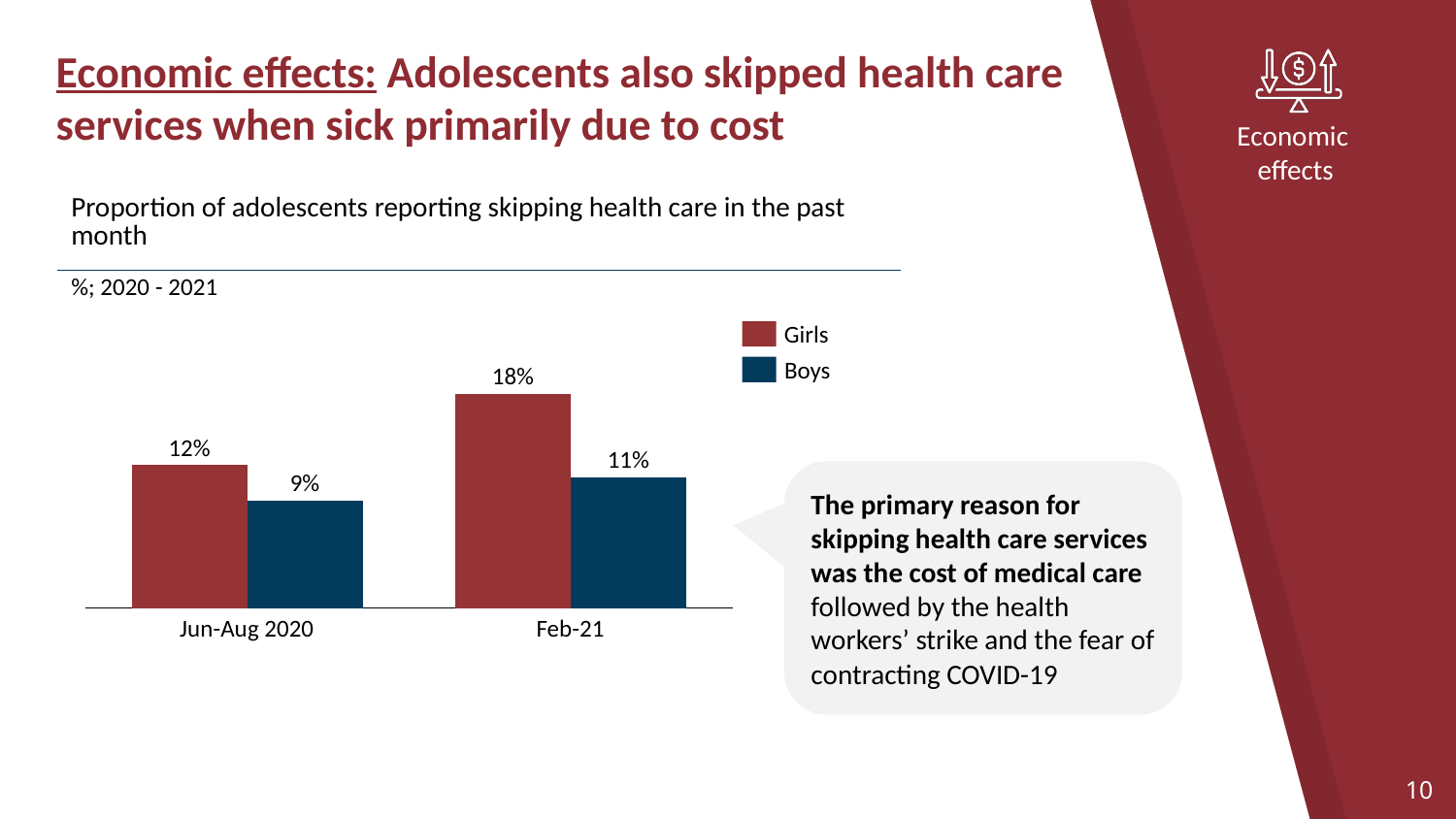
Which is larger: the value for boys in Feb-21 or the value for girls in Jun-Aug 2020? Girls in Jun-Aug 2020 Which group and period has the lowest proportion of adolescents skipping health care? Boys, Jun-Aug 2020 What percentage of girls reported skipping health care in Jun-Aug 2020? 12% Do the values for both girls and boys rise or fall from Jun-Aug 2020 to Feb-21? Rise What kind of chart is shown on the slide? Bar chart What is the value for girls in Feb-21? 18% What is the difference between girls and boys in Feb-21? 7 percentage points What is the value for boys in Jun-Aug 2020? 9% Which group and period has the highest proportion of adolescents skipping health care? Girls, Feb-21 By how much did the proportion of girls skipping health care increase from Jun-Aug 2020 to Feb-21? 6 percentage points How many series does the legend list? 2 What percentage of boys reported skipping health care in Feb-21? 11%